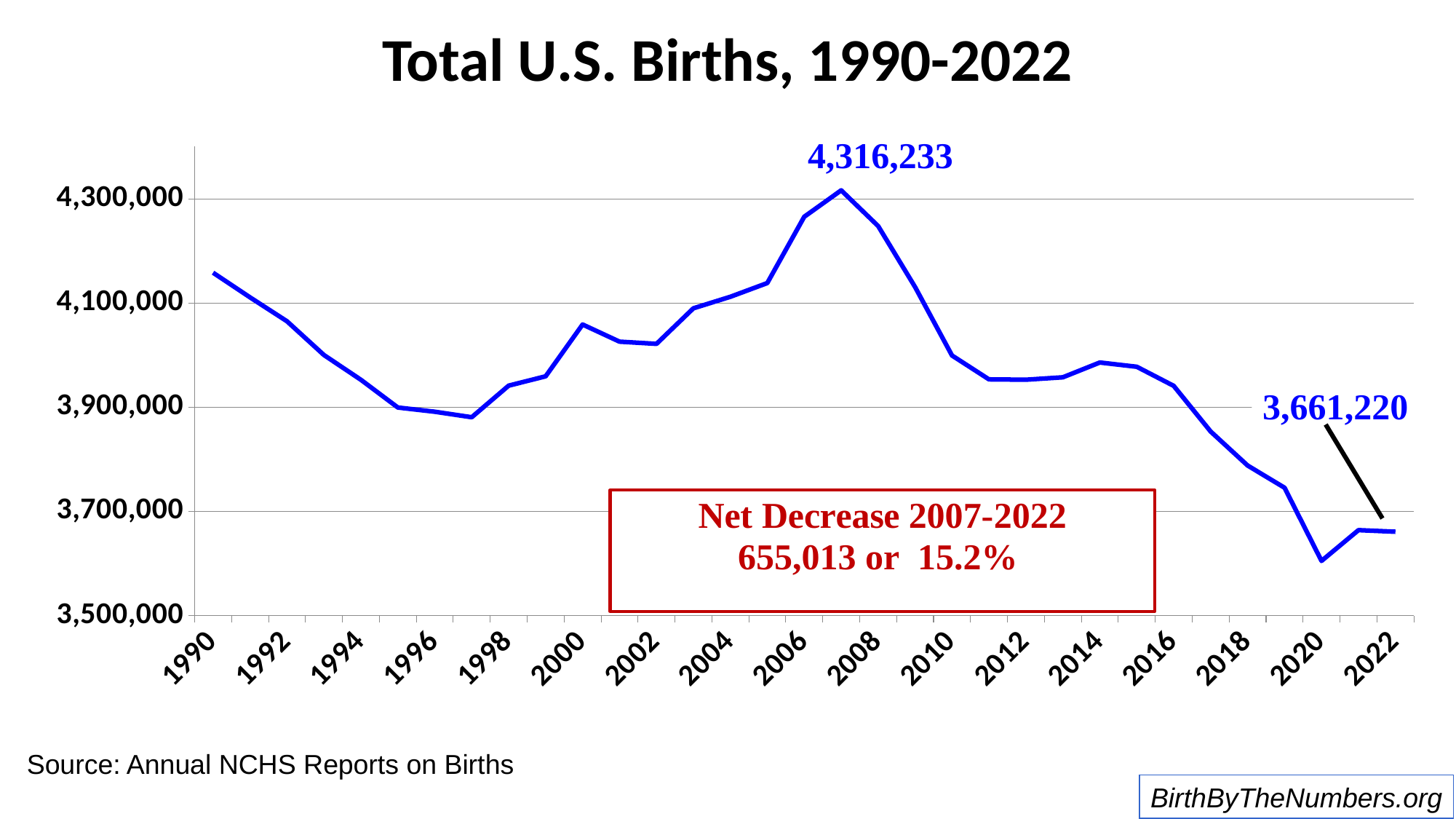
What kind of chart is shown on the slide? line chart What is the peak value of total U.S. births labeled on the chart? 4,316,233 What is the title of the chart? Total U.S. Births, 1990-2022 What is the value of total U.S. births for 2022 as labeled on the chart? 3,661,220 Which year had more total births, 1990 or 2022? 1990 What is the net decrease in total U.S. births from 2007 to 2022? 655,013 In which year did total U.S. births reach their lowest point? 2020 Is the value for 2018 greater or less than 3,900,000? less What percentage decrease in births from 2007 to 2022 is stated on the chart? 15.2% Do total U.S. births rise or fall between 2007 and 2020? fall Is the value for 1990 greater or less than 4,100,000? greater In which year did total U.S. births reach their highest point? 2007